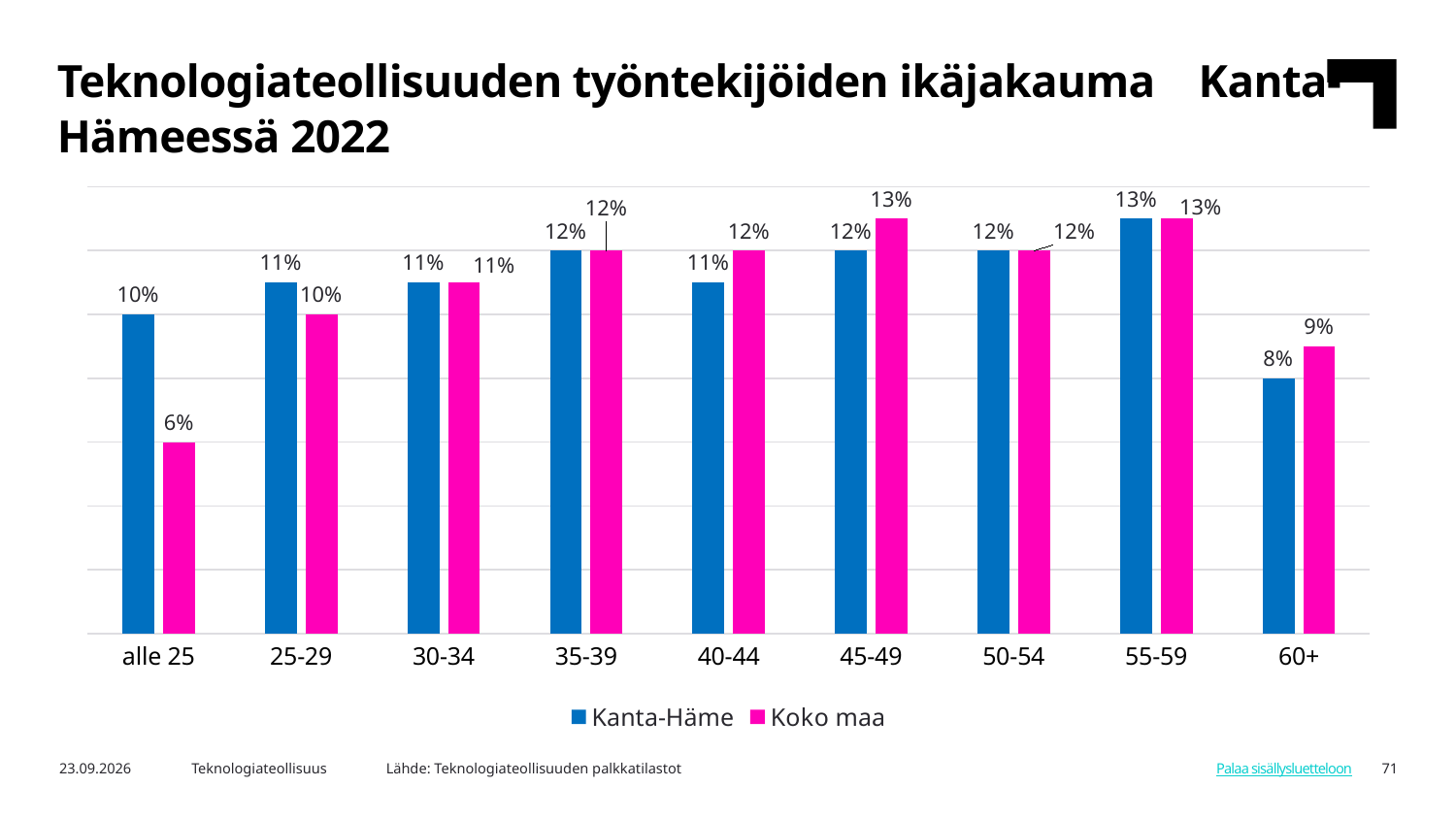
Which age group has the highest value for Kanta-Häme? 55-59 Which age group has the lowest value for Kanta-Häme? 60+ In the 60+ age group, which series has the larger value, Kanta-Häme or Koko maa? Koko maa What is the value for Koko maa in the alle 25 age group? 6% Which age group has the lowest value for Koko maa? alle 25 What kind of chart is shown on the slide? Bar chart What is the value for Koko maa in the 45-49 age group? 13% What is the value for Kanta-Häme in the alle 25 age group? 10% What is the value for Kanta-Häme in the 60+ age group? 8% How many series does the legend list? 2 How many age groups are shown on the x axis? 9 What is the difference between the Kanta-Häme and Koko maa values in the alle 25 age group? 4 percentage points